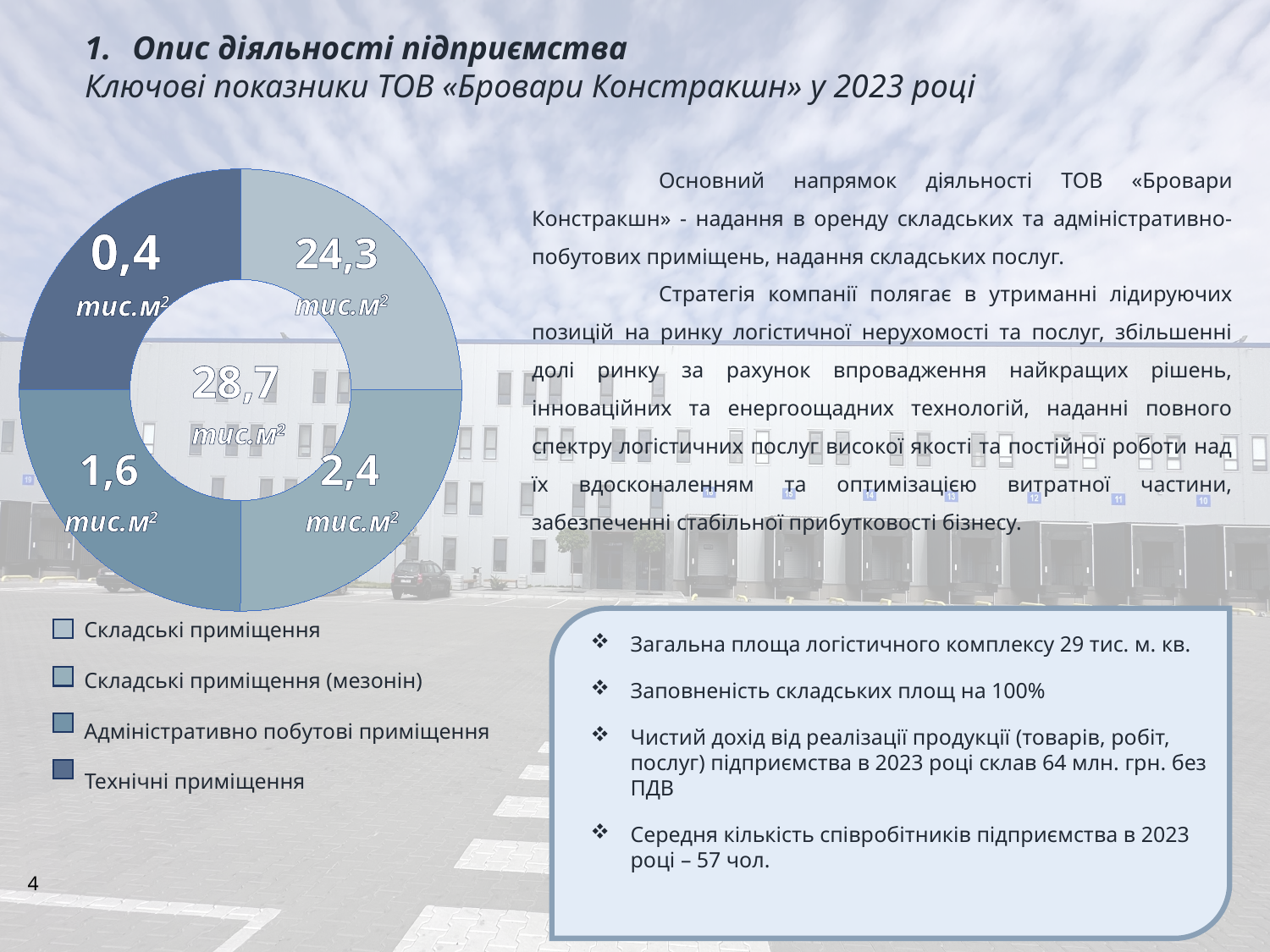
Which legend entry is shown with the darkest blue colour? Технічні приміщення How many segments does the donut chart have? 4 Which is larger on the donut chart: the value for Складські приміщення (мезонін) or the value for Адміністративно побутові приміщення? Складські приміщення (мезонін) What is the total of the four segment values on the donut chart? 28,7 тис.м² What is the value for Складські приміщення on the donut chart? 24,3 тис.м² What is the largest value shown on the donut chart? 24,3 тис.м² What kind of chart is shown on the slide? Donut (pie) chart What is the smallest value shown on the donut chart? 0,4 тис.м² What value is printed in the centre of the donut chart? 28,7 тис.м² What is the value for Технічні приміщення on the donut chart? 0,4 тис.м² What is the difference between the 24,3 тис.м² segment and the 2,4 тис.м² segment? 21,9 тис.м² How many entries does the chart legend list? 4